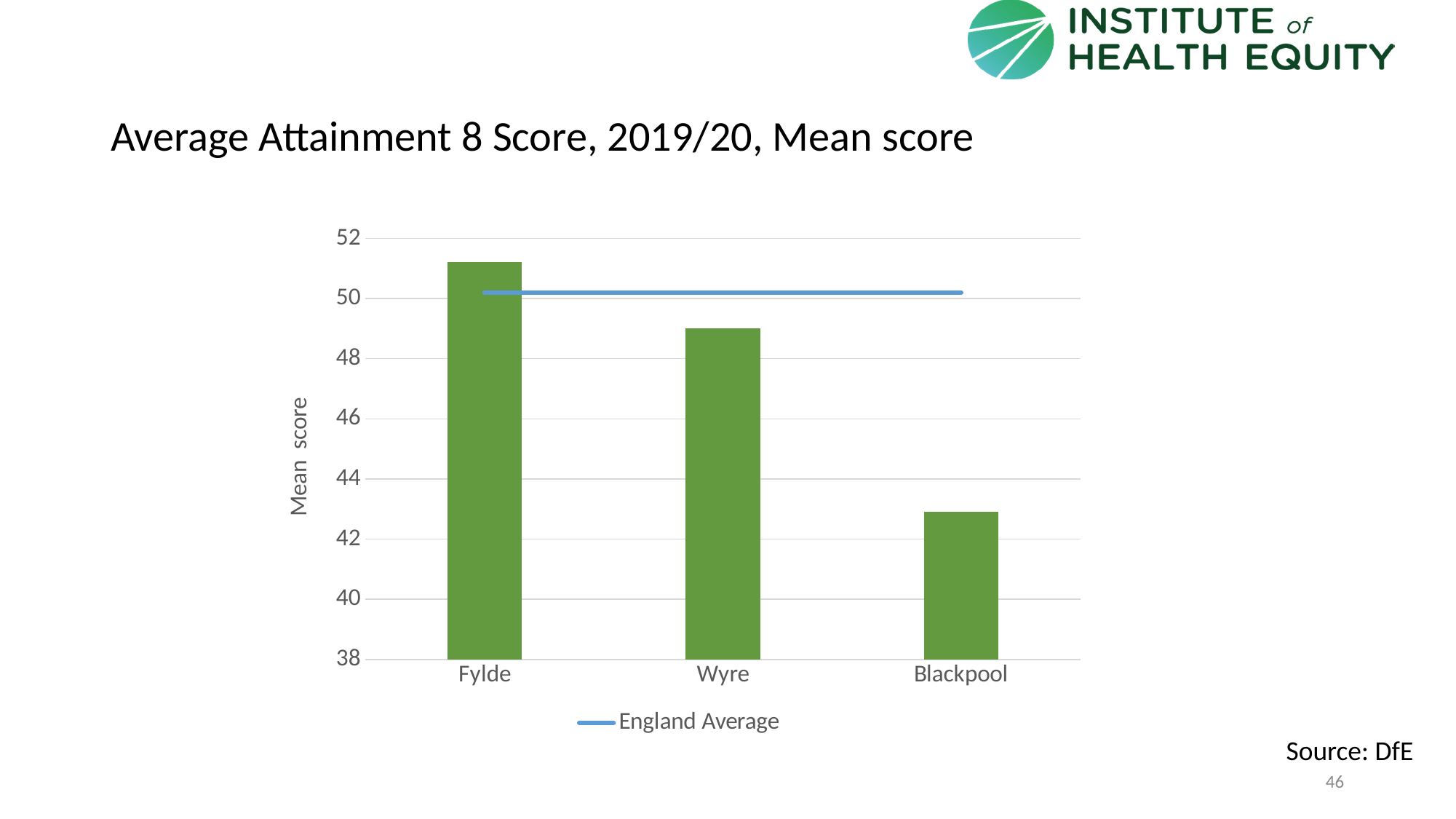
How many series does the legend list? 1 Is the mean score for Blackpool greater or less than 44? less Is the mean score for Fylde greater or less than 50? greater How many local areas (categories) are shown on the x axis? 3 Is the mean score for Fylde above or below the England Average line? Above What type of chart is shown on the slide? Combination bar and line chart Which area has the lowest mean Attainment 8 score? Blackpool Which area has the highest mean Attainment 8 score? Fylde Which has the higher mean score, Wyre or Blackpool? Wyre Do the bar values rise or fall moving from Fylde to Blackpool along the x axis? Fall Is the mean score for Wyre greater or less than 48? greater What is the label on the vertical axis of the chart? Mean score